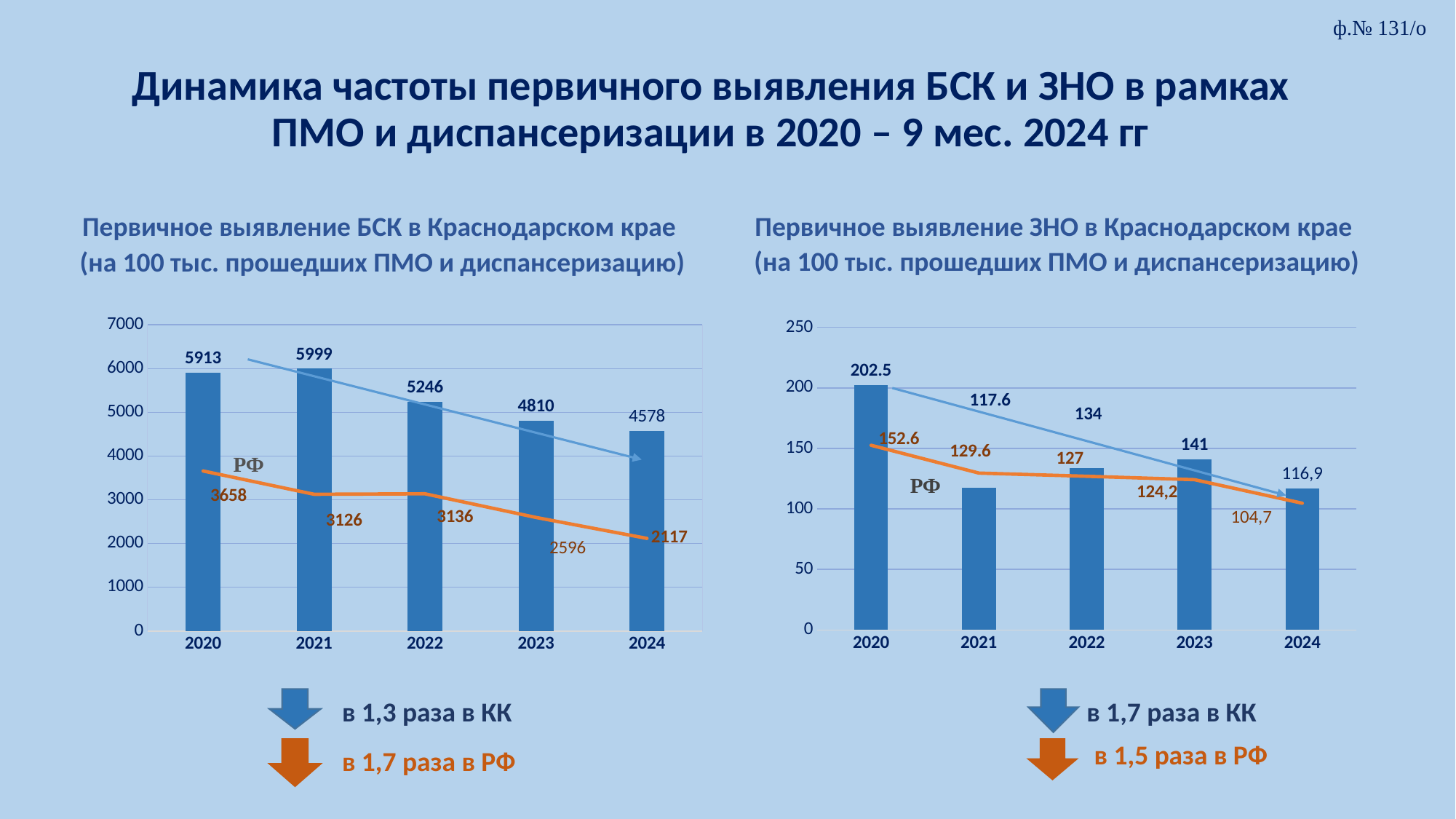
In the left chart (Первичное выявление БСК в Краснодарском крае), what is the bar value for 2021? 5999 In the right chart (Первичное выявление ЗНО в Краснодарском крае), is the bar for 2021 greater or less than 150? less In the left chart (Первичное выявление БСК в Краснодарском крае), which year has the highest bar? 2021 In the right chart (Первичное выявление ЗНО в Краснодарском крае), what is the РФ line value for 2020? 152.6 In the right chart (Первичное выявление ЗНО в Краснодарском крае), is the bar for 2022 or the bar for 2023 larger? 2023 In the right chart (Первичное выявление ЗНО в Краснодарском крае), what is the bar value for 2020? 202.5 In the left chart (Первичное выявление БСК в Краснодарском крае), what is the difference between the 2020 bar value and the 2024 bar value? 1335 In the left chart (Первичное выявление БСК в Краснодарском крае), what is the РФ line value for 2024? 2117 In the left chart (Первичное выявление БСК в Краснодарском крае), how many years are shown on the x axis? 5 In the right chart (Первичное выявление ЗНО в Краснодарском крае), which year has the lowest bar? 2024 What kind of chart is used for the Краснодарский край values in the left chart? bar chart In the left chart (Первичное выявление БСК в Краснодарском крае), what is the bar value for 2024? 4578